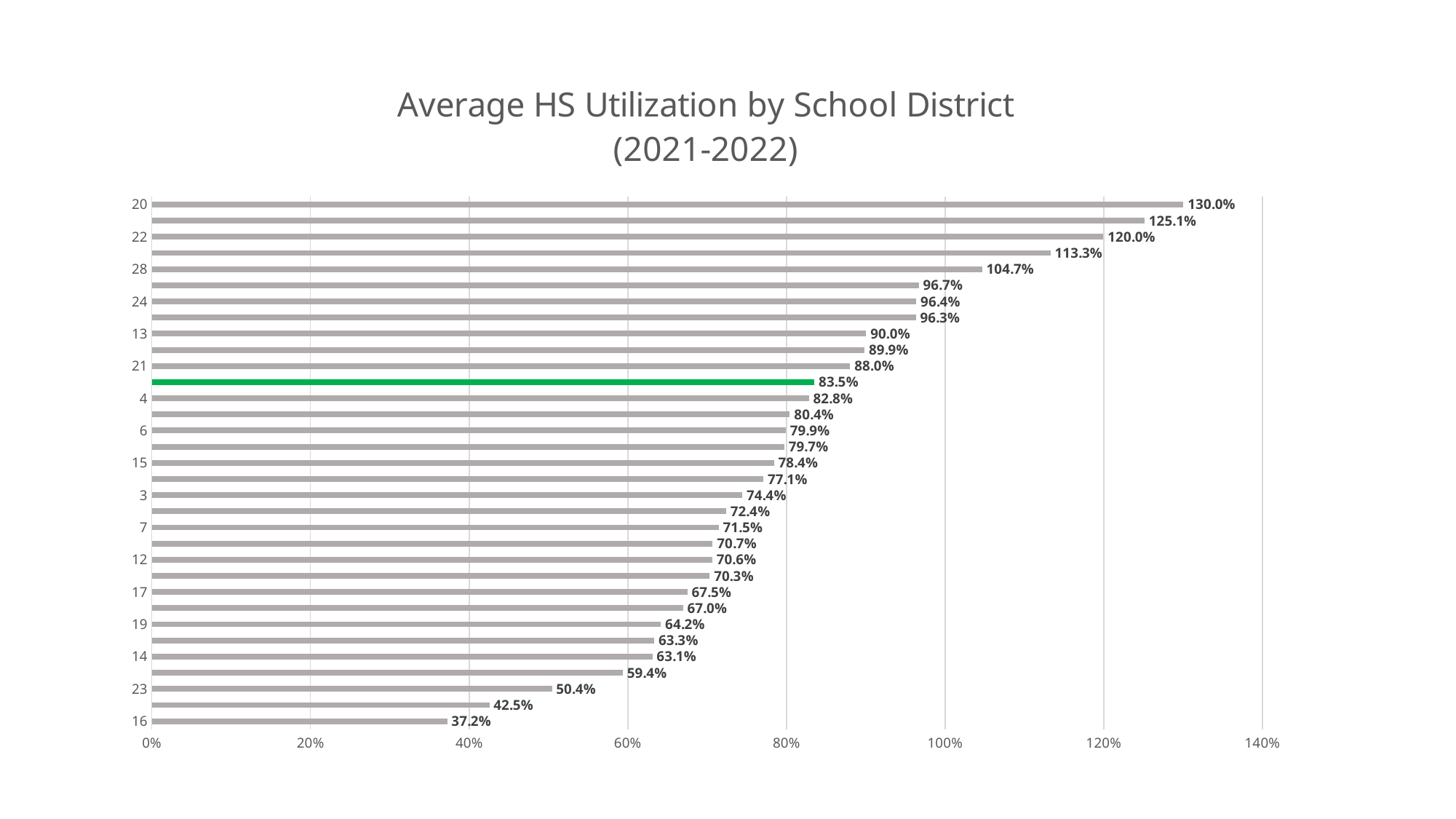
What is the difference in average HS utilization between school district 20 and school district 16? 92.8 percentage points What is the average HS utilization for school district 23? 50.4% What value is shown on the green highlighted bar? 83.5% What is the average HS utilization for school district 16? 37.2% How many bars are plotted in the chart? 33 Which school district has the highest average HS utilization? 20 What kind of chart is shown on the slide? Bar chart Is the value for school district 22 greater or less than 100%? greater Which has a higher average HS utilization, school district 24 or school district 13? 24 What is the average HS utilization for school district 28? 104.7% What is the average HS utilization for school district 20? 130.0% Which school district has the lowest average HS utilization? 16